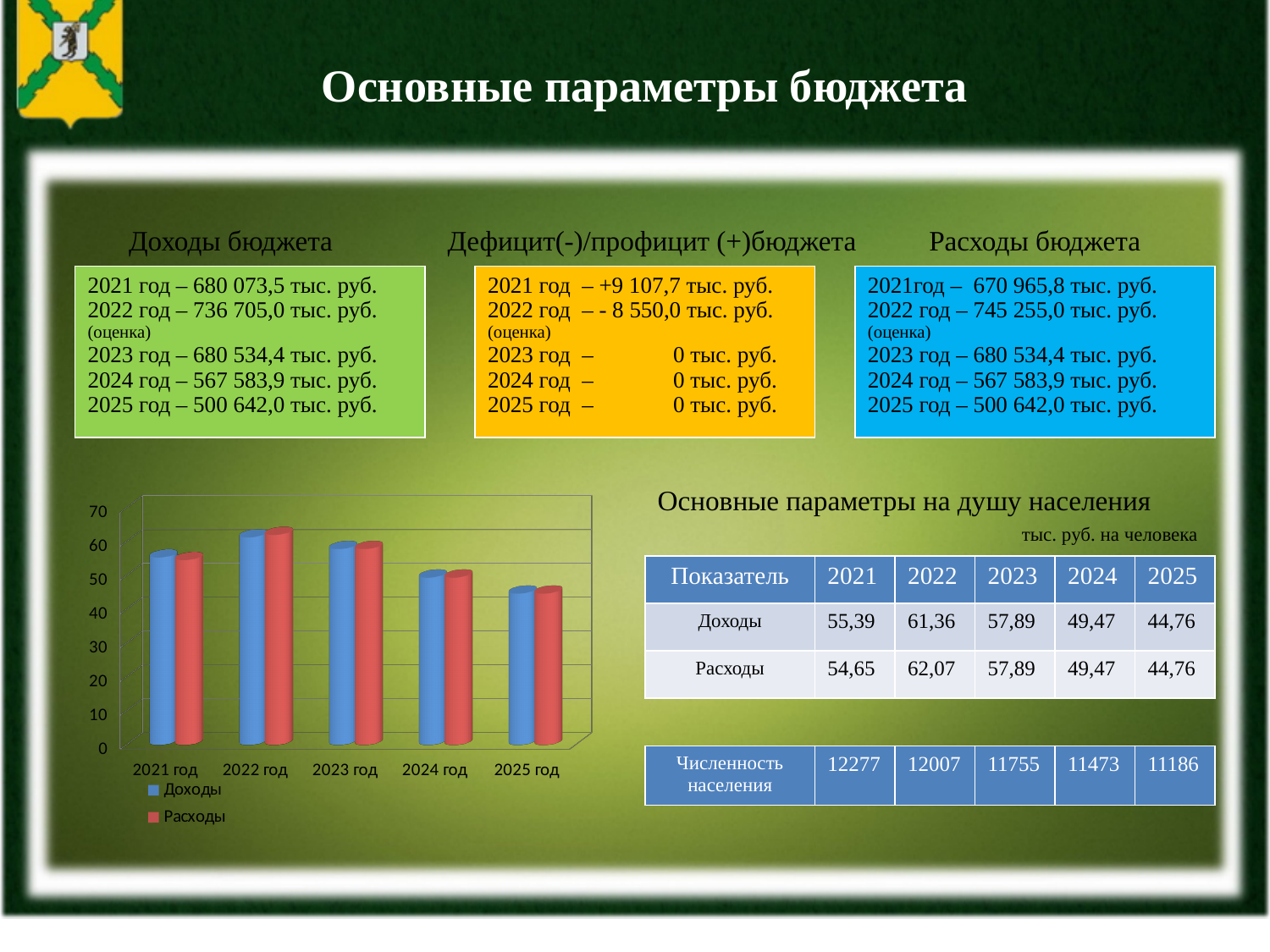
Do the Доходы bars rise or fall from 2022 год to 2025 год? fall Which colour represents the Доходы series in the chart's legend? blue How many series does the chart's legend list? 2 Is the Доходы bar for 2025 год greater or less than 50? less Which year has the highest Доходы bar on the chart? 2022 год How many year categories are shown on the chart's x axis? 5 Is the Доходы bar for 2021 год greater or less than 50? greater Is the Расходы bar for 2024 год greater or less than 40? greater Which is larger on the chart: the Доходы bar for 2023 год or the Доходы bar for 2024 год? 2023 год What kind of chart is shown on the slide? bar chart Which year has the lowest Расходы bar on the chart? 2025 год